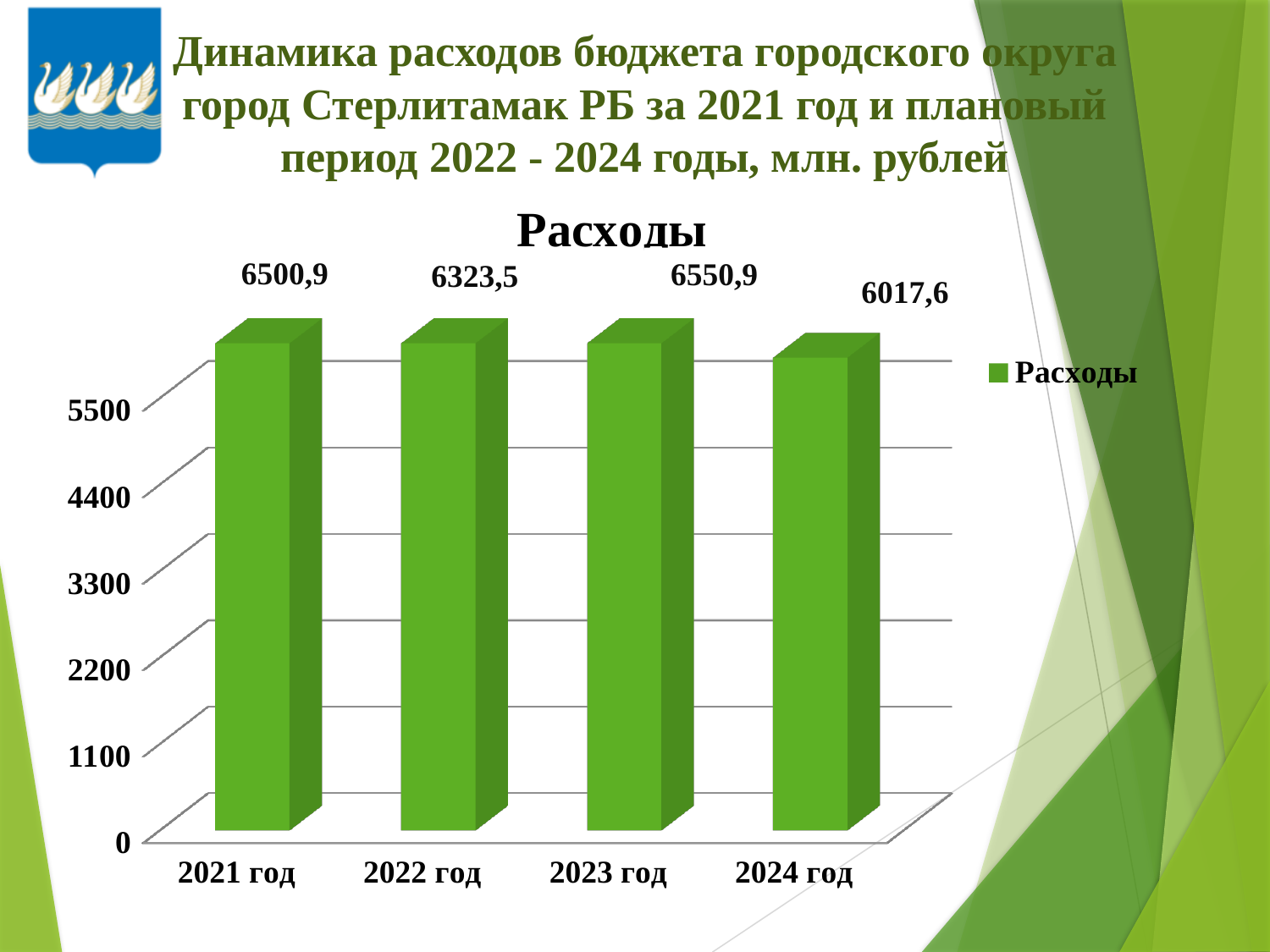
What is the value for 2023 год in the Расходы chart? 6550,9 What is the value for 2021 год in the Расходы chart? 6500,9 What is the value for 2022 год in the Расходы chart? 6323,5 What is the difference between the values for 2023 год and 2024 год? 533,3 What is the difference between the values for 2021 год and 2022 год? 177,4 What is the title of the chart? Расходы What is the value for 2024 год in the Расходы chart? 6017,6 Which year has the lowest value in the Расходы chart? 2024 год How many years are shown on the x axis of the chart? 4 Which is larger, the value for 2022 год or the value for 2024 год? 2022 год What kind of chart is shown on the slide? bar chart Which year has the highest value in the Расходы chart? 2023 год